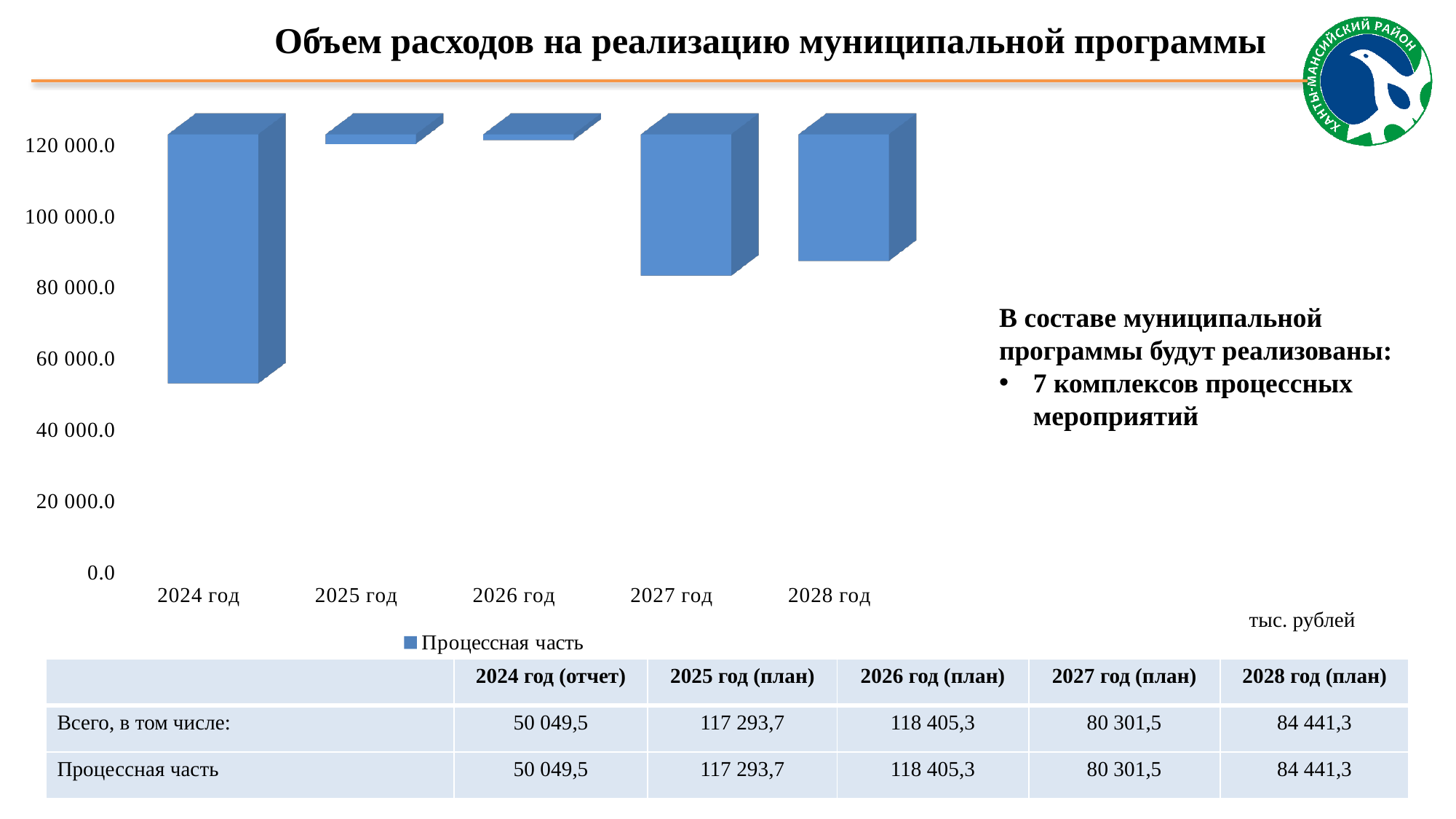
Which is larger, the value for 2027 год or the value for 2028 год? 2028 год What is the name of the series in the chart legend? Процессная часть How many years are shown on the x axis of the chart? 5 How many series does the legend list? 1 Which year has the lowest value? 2024 год What is the value for 2024 год in the chart (as printed in the table)? 50 049,5 Which year has the highest value? 2026 год What kind of chart is shown on the slide? Bar chart What is the difference between the values for 2026 год and 2025 год? 1 111,6 What is the value for 2028 год? 84 441,3 What is the difference between the values for 2028 год and 2027 год? 4 139,8 What is the value for 2026 год? 118 405,3